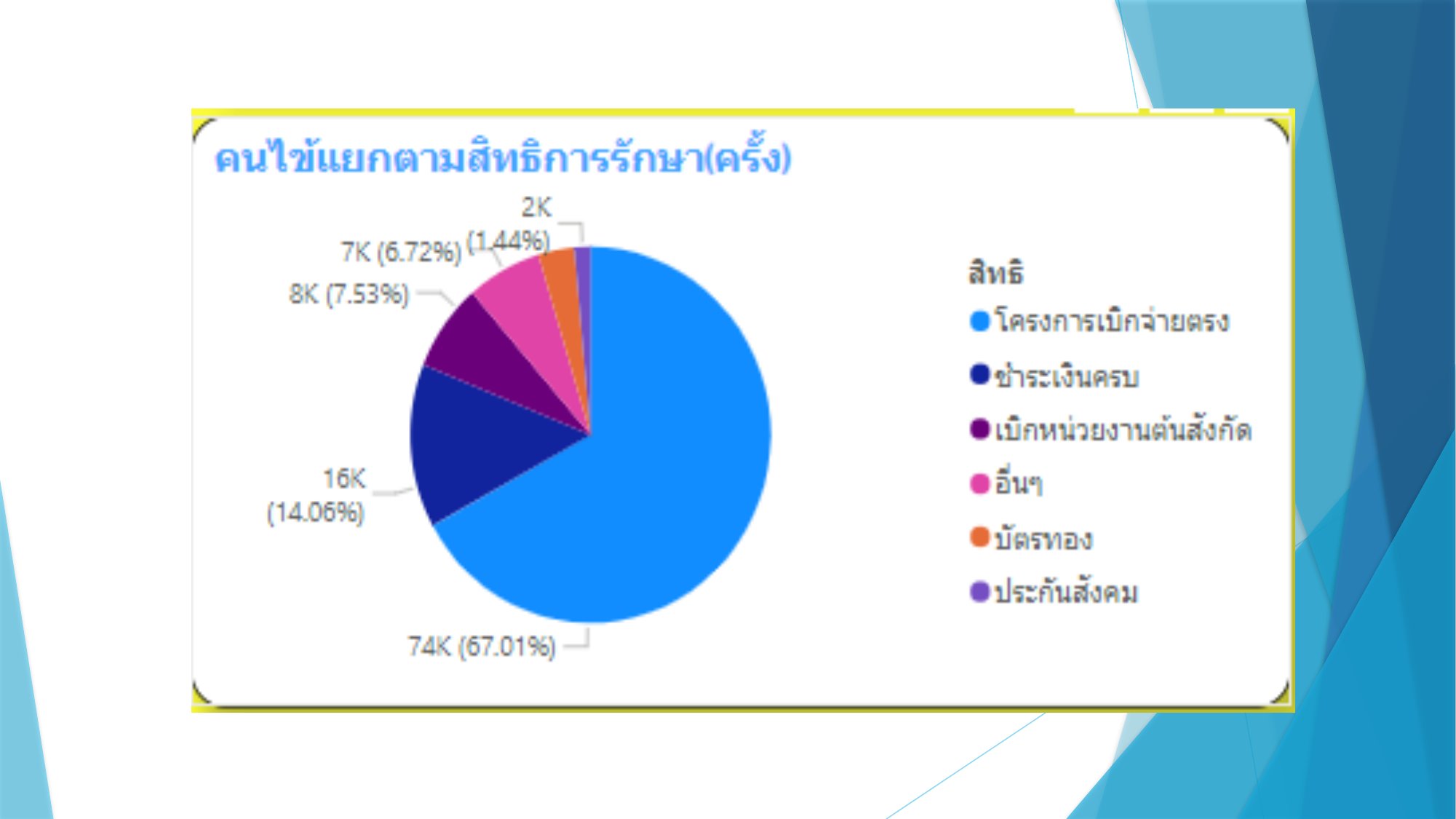
What value is shown for โครงการเบิกจ่ายตรง? 74K How many categories does the legend list? 6 What share of the pie does ชำระเงินครบ represent? 14.06% What value is shown for ชำระเงินครบ? 16K Which category has the largest slice of the pie? โครงการเบิกจ่ายตรง What share of the pie does เบิกหน่วยงานต้นสังกัด represent? 7.53% What value is shown for อื่นๆ? 7K What share of the pie does โครงการเบิกจ่ายตรง represent? 67.01% What kind of chart is shown on the slide? pie chart What is the title of the chart? คนไข้แยกตามสิทธิการรักษา(ครั้ง) What is the difference between the values for โครงการเบิกจ่ายตรง and ชำระเงินครบ? 58K Which is larger, the slice for ชำระเงินครบ or the slice for เบิกหน่วยงานต้นสังกัด? ชำระเงินครบ